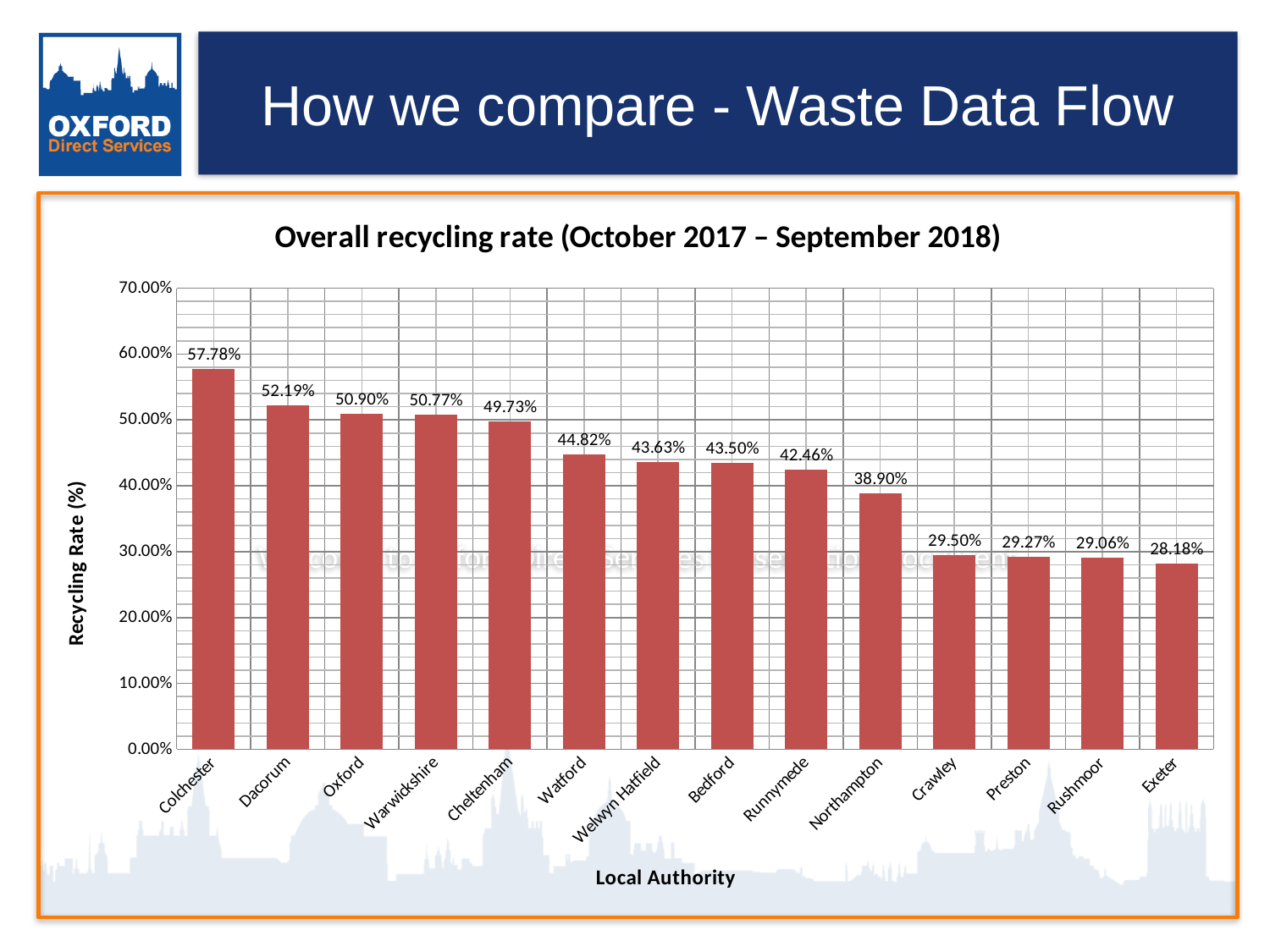
What is the overall recycling rate for Oxford? 50.90% What type of chart is used to show the overall recycling rates? Bar chart Which local authority has the highest overall recycling rate? Colchester What is the overall recycling rate for Northampton? 38.90% Is the recycling rate for Crawley greater or less than 30.00%? less Which local authority has the lowest overall recycling rate? Exeter What is the title of the chart? Overall recycling rate (October 2017 – September 2018) Which has a higher recycling rate, Watford or Runnymede? Watford How many local authorities are shown in the chart? 14 What is the difference between the recycling rates of Colchester and Exeter? 29.60 percentage points What is the difference between the recycling rates of Dacorum and Oxford? 1.29 percentage points What is the overall recycling rate for Welwyn Hatfield? 43.63%